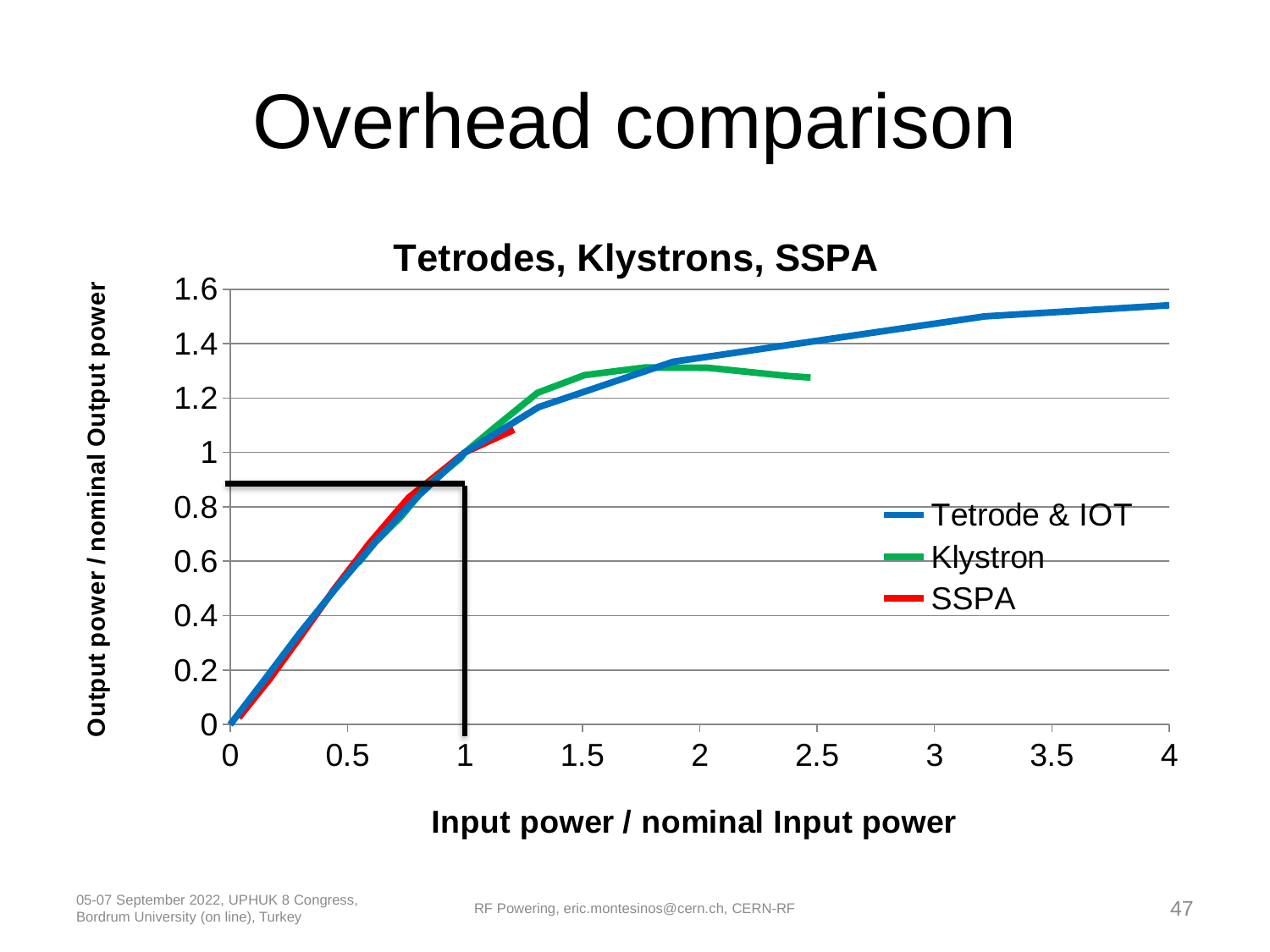
How many series does the legend list? 3 Which series reaches the highest output power value on the chart? Tetrode & IOT What kind of chart is shown on the slide? line chart Is the value of the Tetrode & IOT series at an input power of 4 greater or less than 1.4? greater Is the value of the Tetrode & IOT series at an input power of 2 greater or less than 1.4? less Is the value of the Klystron series at an input power of 2.5 greater or less than 1.4? less Does the Tetrode & IOT series rise or fall as input power increases from 0 to 4? rise Which series extends to the largest input power value on the x axis? Tetrode & IOT What is the label of the x axis? Input power / nominal Input power What is the title of the chart? Tetrodes, Klystrons, SSPA Which series ends at the smallest input power value on the x axis? SSPA At an input power of 2.5, which series has the larger value, Tetrode & IOT or Klystron? Tetrode & IOT